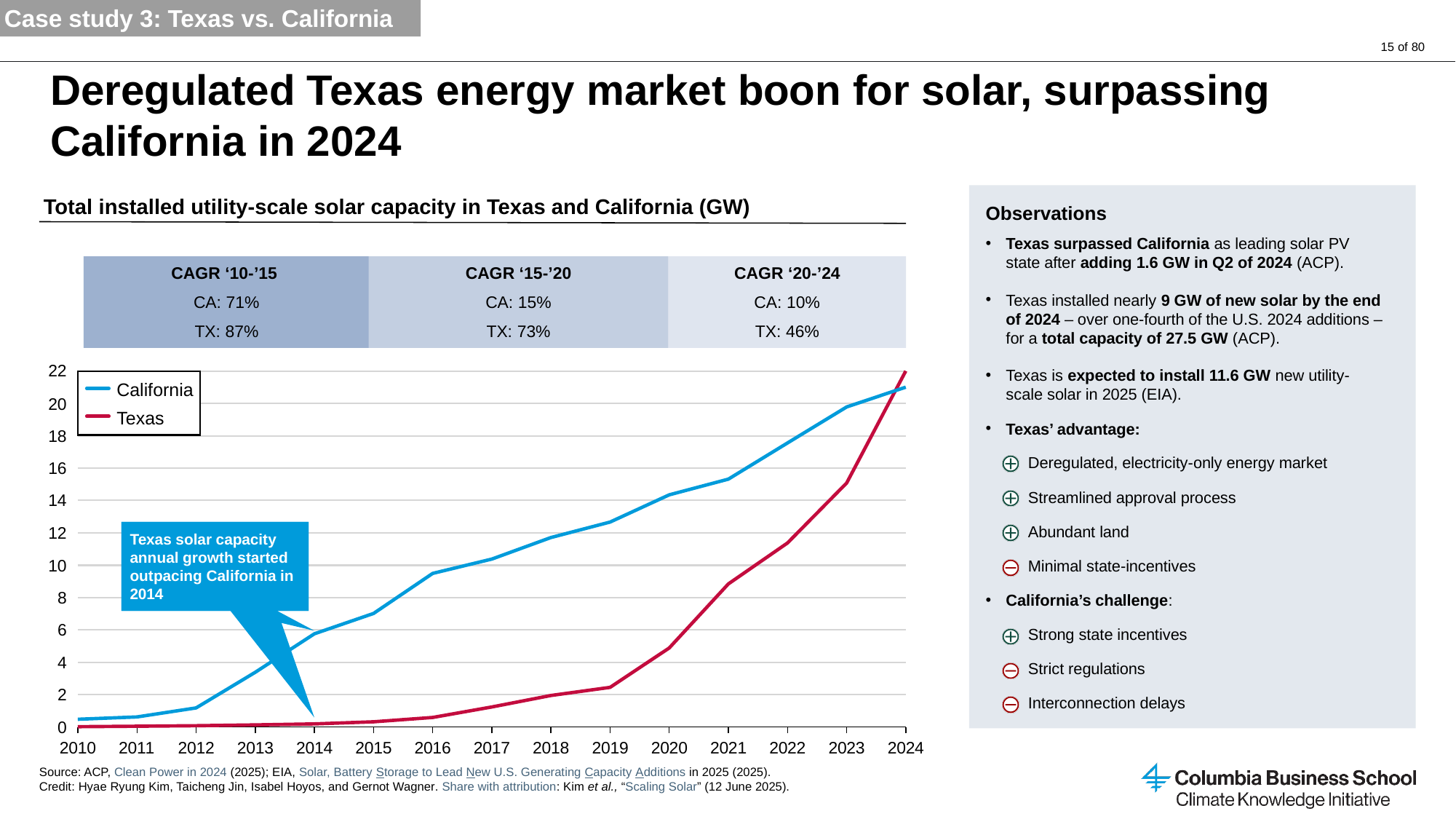
Does the Texas line rise or fall from 2010 to 2024? rise What kind of chart is shown on the slide? line chart How many years are shown along the x axis of the chart? 15 Which series has the higher installed solar capacity in 2024, California or Texas? Texas Is the value for Texas in 2019 greater or less than 2? greater Is the value for California in 2016 greater or less than 10? less What is the CAGR for Texas over 2015-2020 shown above the chart? 73% Which series has the higher installed solar capacity in 2020, California or Texas? California How many series does the chart legend list? 2 Is the value for Texas in 2022 greater or less than 10? greater What is the title of the chart? Total installed utility-scale solar capacity in Texas and California (GW)